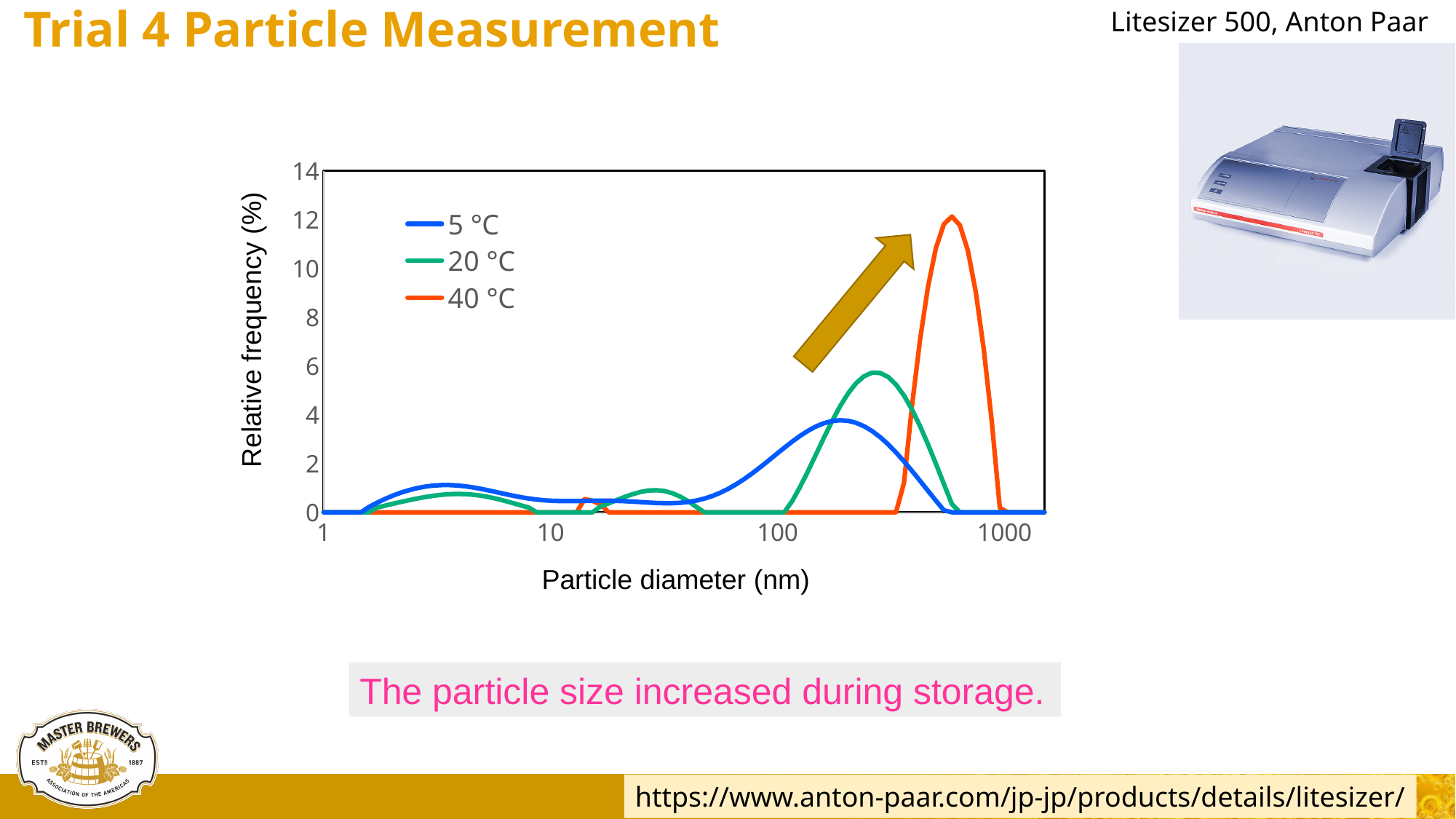
What kind of chart is shown on the slide? line chart Which series has the highest peak relative frequency? 40 °C Is the peak relative frequency of the 20 °C series greater or less than 4%? greater Is the peak relative frequency of the 40 °C series greater or less than 10%? greater Which series reaches a higher peak, 20 °C or 40 °C? 40 °C As the storage temperature increases from 5 °C to 40 °C, does the main peak shift to larger or smaller particle diameters? larger Is the peak relative frequency of the 5 °C series greater or less than 6%? less What is the label of the x axis? Particle diameter (nm) What colour is the line for the 40 °C series? orange How many series does the chart legend list? 3 Which series has the lowest peak relative frequency? 5 °C